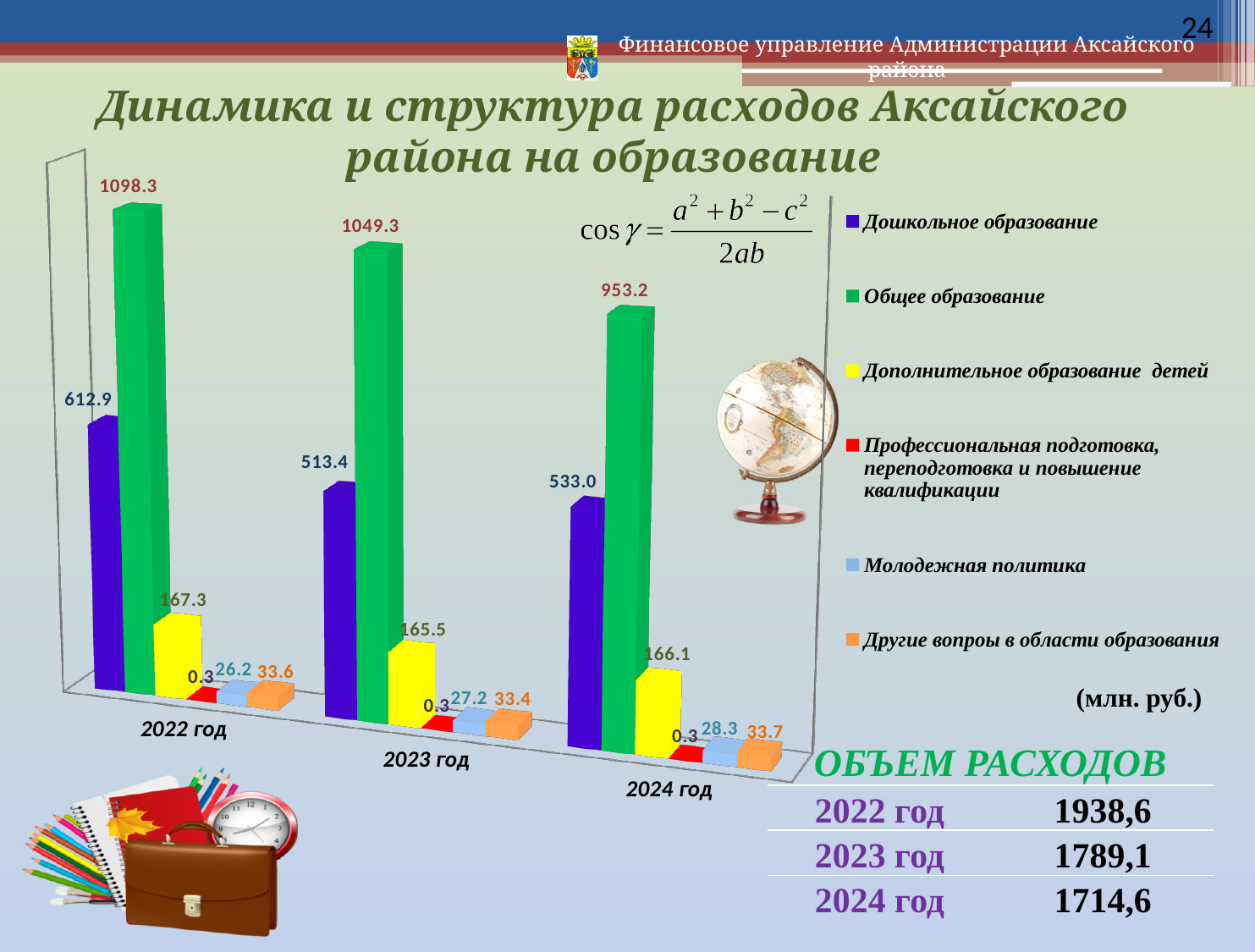
What is the difference between Общее образование in 2022 год and in 2024 год? 145.1 Do the values for Общее образование rise or fall from 2022 год to 2024 год? fall What type of chart is shown on the slide? bar chart Which is larger: Дошкольное образование in 2023 год or in 2024 год? 2024 год Which series has the highest value in 2024 год? Общее образование What is the value for Молодежная политика in 2024 год? 28.3 Which series has the lowest value in 2022 год? Профессиональная подготовка, переподготовка и повышение квалификации What is the value for Общее образование in 2022 год? 1098.3 What is the value for Дополнительное образование детей in 2024 год? 166.1 What is the value for Дошкольное образование in 2023 год? 513.4 How many series does the legend list? 6 How many year categories are shown on the x axis? 3